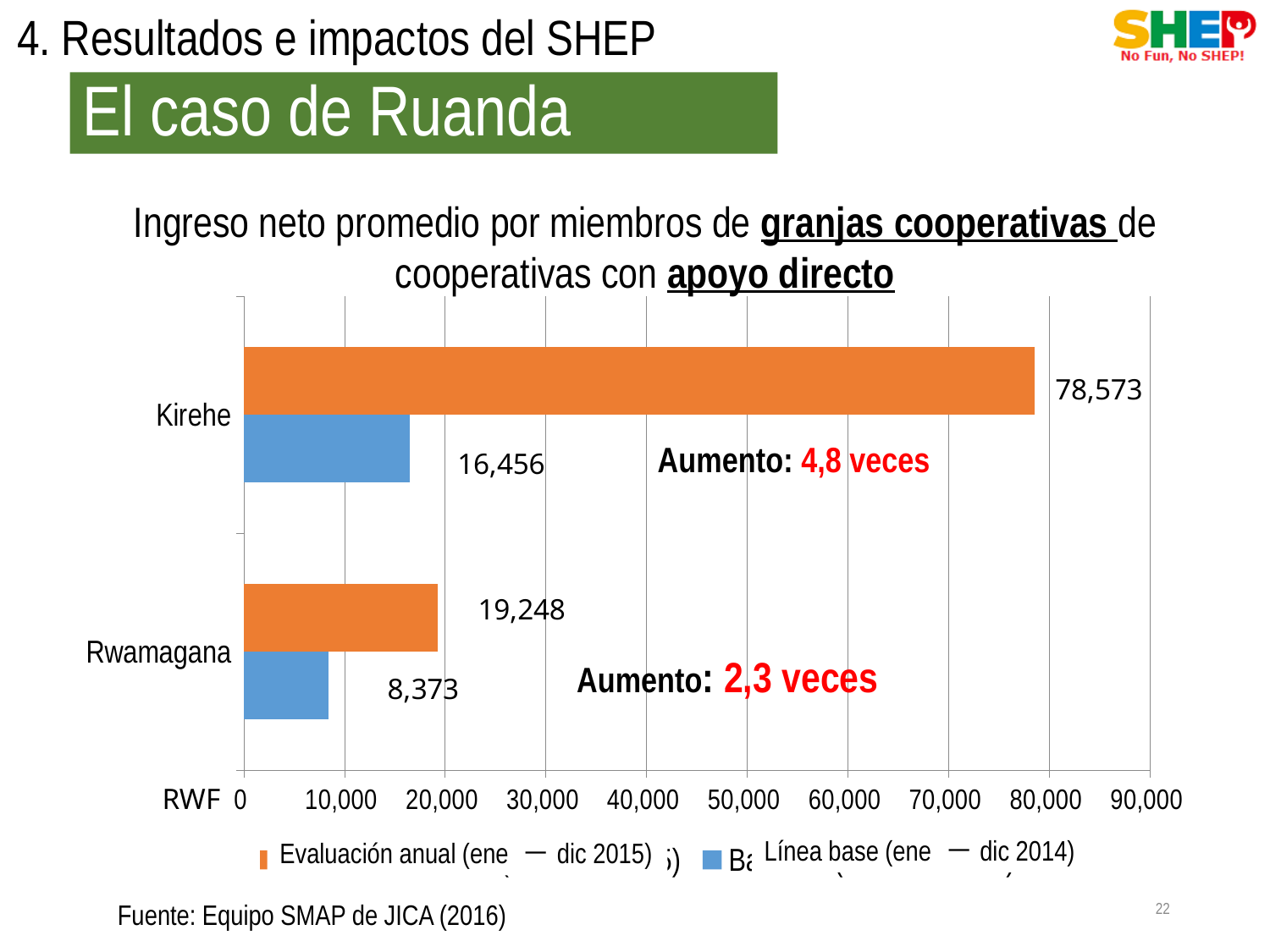
What kind of chart is shown on the slide? Bar chart What is the value for Kirehe in the Evaluación anual (ene – dic 2015) series? 78,573 What is the value for Kirehe in the Línea base (ene – dic 2014) series? 16,456 What is the value for Rwamagana in the Evaluación anual (ene – dic 2015) series? 19,248 Which category has the lowest value in the Línea base (ene – dic 2014) series? Rwamagana How many categories are shown on the chart? 2 What is the difference between the Evaluación anual and Línea base values for Kirehe? 62,117 Which is larger: the Línea base value for Kirehe or the Evaluación anual value for Rwamagana? Evaluación anual value for Rwamagana What is the difference between the Evaluación anual and Línea base values for Rwamagana? 10,875 How many series does the legend list? 2 What is the value for Rwamagana in the Línea base (ene – dic 2014) series? 8,373 Which category has the highest value in the Evaluación anual (ene – dic 2015) series? Kirehe